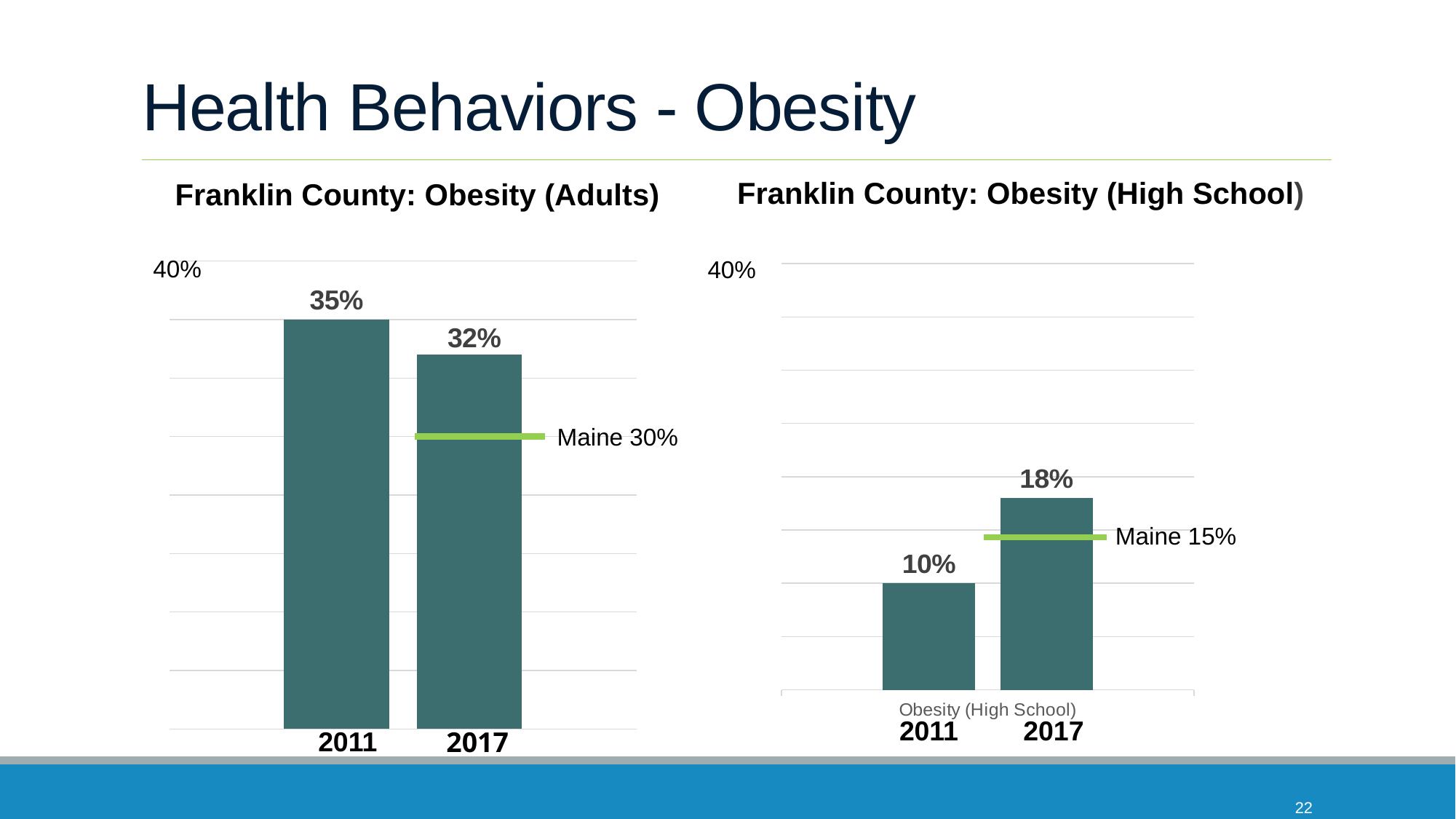
Do the values in the 'Franklin County: Obesity (Adults)' chart rise or fall from 2011 to 2017? fall In the 'Franklin County: Obesity (High School)' chart, what is the difference between the 2017 and 2011 values? 8% In the 'Franklin County: Obesity (High School)' chart, is the 2017 value greater or less than the Maine 15% reference line? greater In the 'Franklin County: Obesity (High School)' chart, which year has the lower value? 2011 In the 'Franklin County: Obesity (Adults)' chart, what is the value for 2011? 35% What kind of chart is the 'Franklin County: Obesity (Adults)' chart? bar chart In the 'Franklin County: Obesity (Adults)' chart, which year has the higher value? 2011 In the 'Franklin County: Obesity (High School)' chart, what is the value for 2011? 10% How many bars are plotted in the 'Franklin County: Obesity (High School)' chart? 2 In the 'Franklin County: Obesity (High School)' chart, what is the value for 2017? 18% In the 'Franklin County: Obesity (Adults)' chart, what is the value for 2017? 32% In the 'Franklin County: Obesity (Adults)' chart, what is the difference between the 2011 and 2017 values? 3%